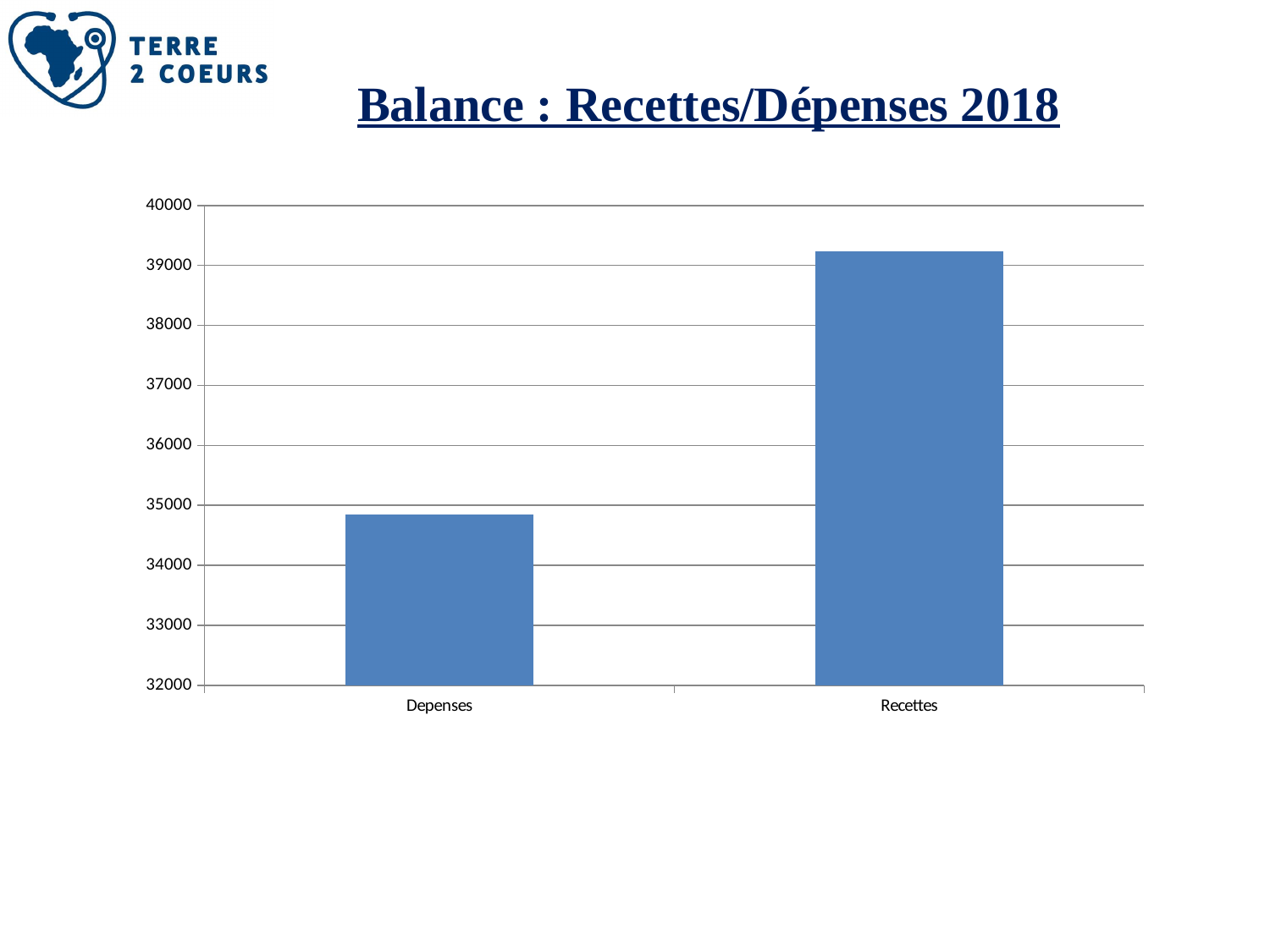
Which category has the lowest value in the chart? Depenses What kind of chart is shown on the slide? bar chart Which is larger, the value for Depenses or the value for Recettes? Recettes What is the lowest value shown on the y axis of the chart? 32000 Which category has the highest value in the chart? Recettes What is the title of the slide containing the chart? Balance : Recettes/Dépenses 2018 Is the value for Recettes greater or less than 40000? less How many categories are shown on the x axis of the chart? 2 Is the value for Depenses greater or less than 34000? greater Is the value for Recettes greater or less than 39000? greater